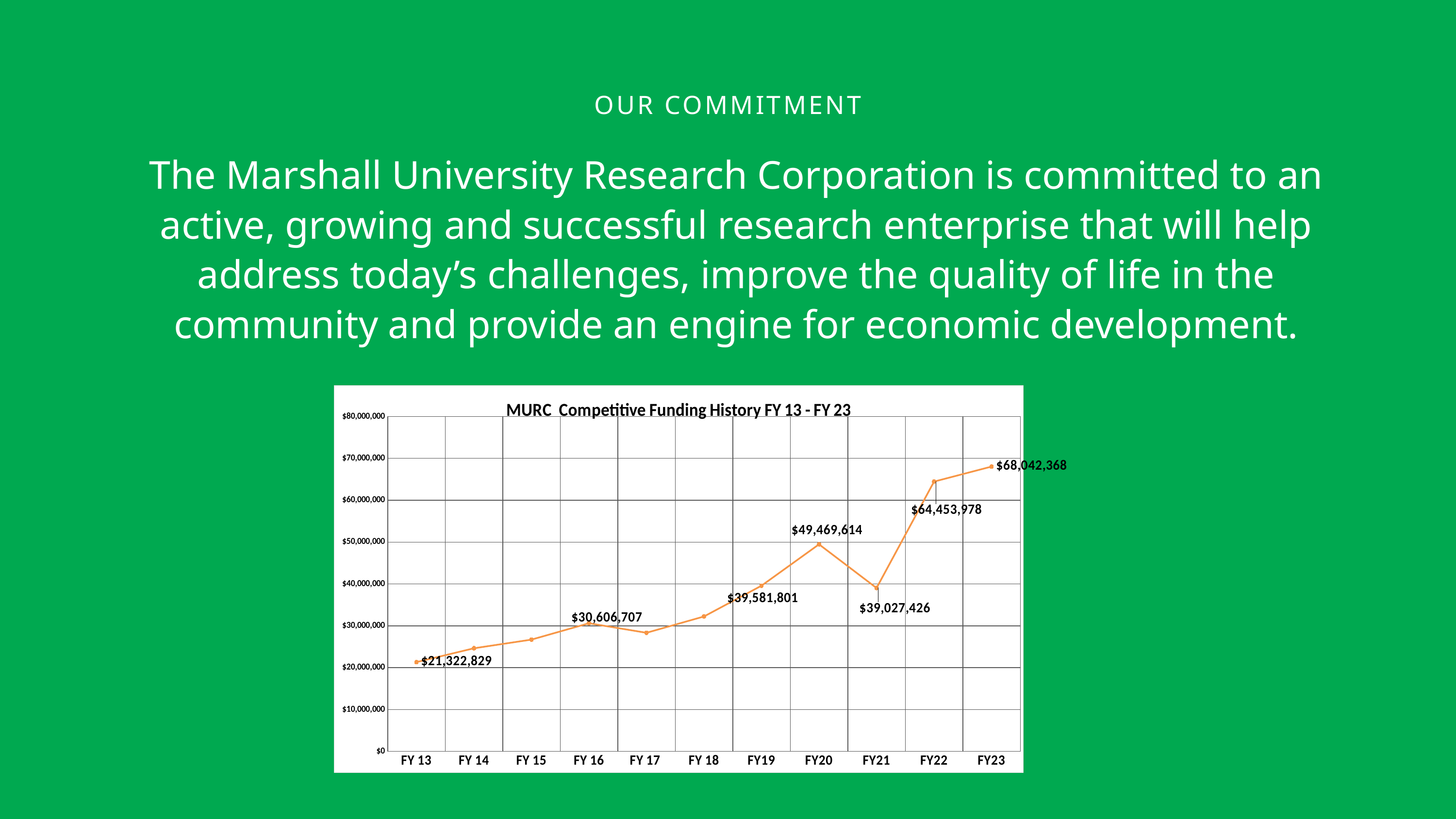
What type of chart is shown on the slide? Line chart Which fiscal year has the lowest competitive funding? FY 13 What is the competitive funding value for FY 13? $21,322,829 What is the competitive funding value for FY23? $68,042,368 Which is larger, the funding value for FY19 or for FY21? FY19 What is the competitive funding value for FY 16? $30,606,707 What is the competitive funding value for FY20? $49,469,614 Is the value for FY 17 greater or less than $30,000,000? less What is the title of the chart? MURC Competitive Funding History FY 13 - FY 23 How many fiscal years are plotted on the x axis of the chart? 11 Which fiscal year has the highest competitive funding? FY23 What is the difference between the FY23 and FY22 funding values? $3,588,390